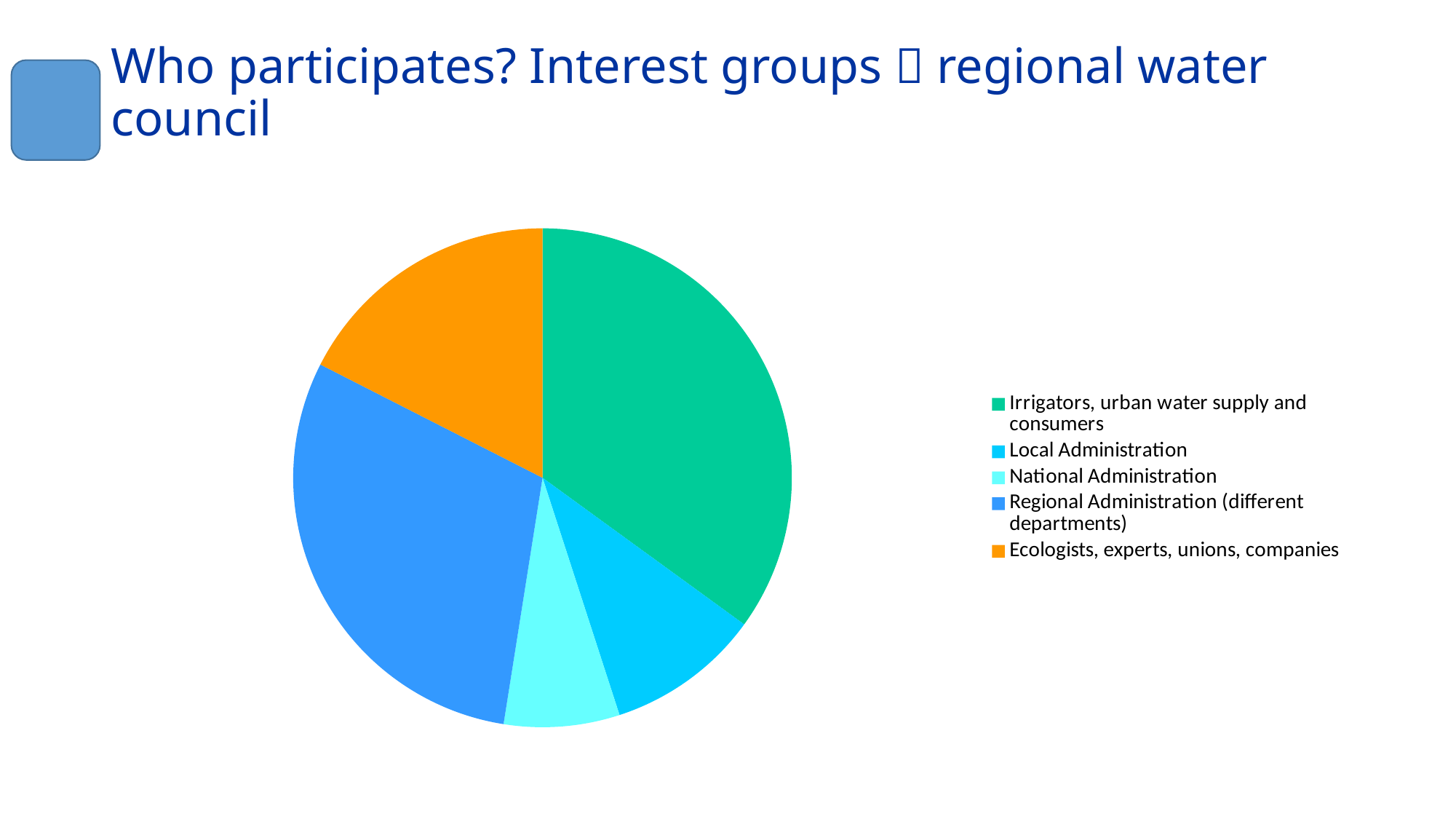
Which interest group is represented by the green slice? Irrigators, urban water supply and consumers Which slice is larger: Irrigators, urban water supply and consumers or Regional Administration (different departments)? Irrigators, urban water supply and consumers How many entries does the legend of the pie chart list? 5 Which slice is larger: Regional Administration (different departments) or Ecologists, experts, unions, companies? Regional Administration (different departments) How many slices does the pie chart have? 5 Which interest group has the smallest slice of the pie chart? National Administration What colour is the slice for Ecologists, experts, unions, companies? orange Which slice is larger: Ecologists, experts, unions, companies or Local Administration? Ecologists, experts, unions, companies What kind of chart is shown on the slide? pie chart Which interest group has the largest slice of the pie chart? Irrigators, urban water supply and consumers